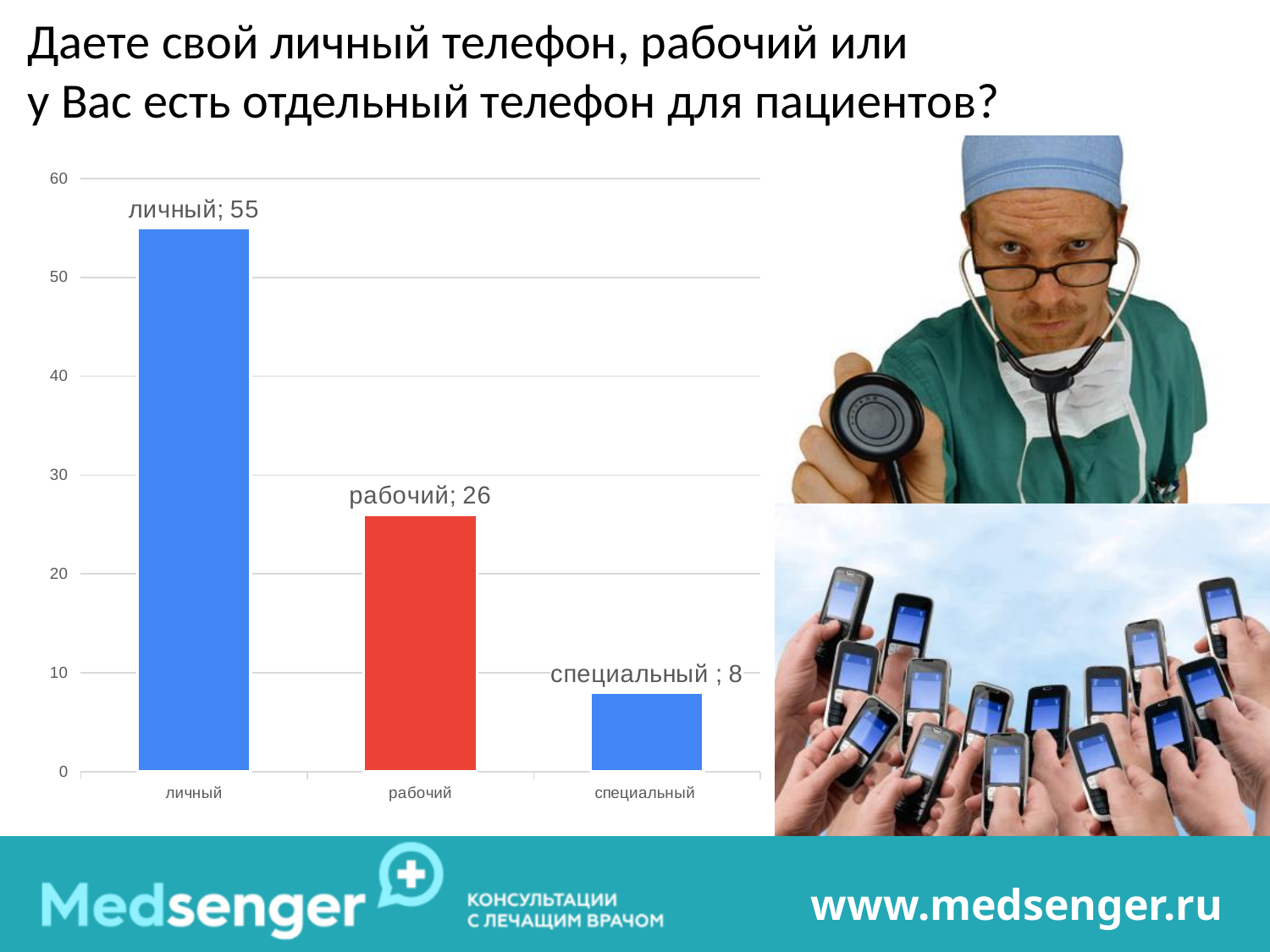
What is the value for личный? 55 Which category has the highest value? личный How many categories are shown on the x axis? 3 What kind of chart is shown on the slide? bar chart Is the value for рабочий greater or less than 30? less What is the difference between the values for рабочий and специальный? 18 What is the value for специальный? 8 Which category has the lowest value? специальный What is the difference between the values for личный and рабочий? 29 What is the value for рабочий? 26 Which is larger, the value for рабочий or the value for специальный? рабочий Do the values rise or fall from left to right along the x axis? fall